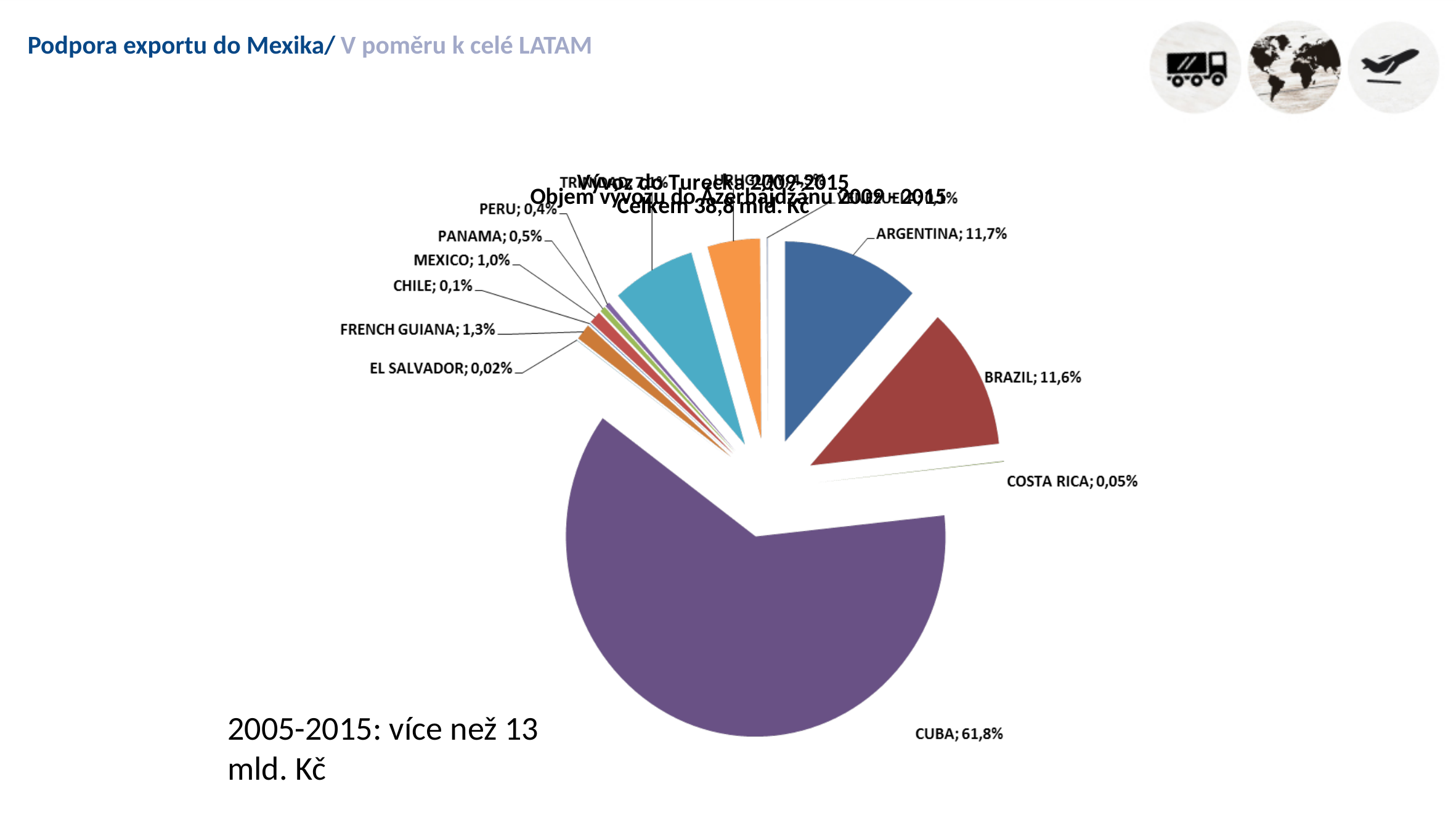
What is the difference in percentage points between CUBA and ARGENTINA? 50,1% What is the value shown for PANAMA? 0,5% What colour is the CUBA slice? purple What is the value shown for MEXICO? 1,0% What share of the pie does CUBA hold? 61,8% What is the value shown for EL SALVADOR? 0,02% What is the value shown for FRENCH GUIANA? 1,3% What is the value shown for BRAZIL? 11,6% What is the value shown for COSTA RICA? 0,05% What kind of chart is shown on the slide? pie chart Which country has the largest slice of the pie? CUBA What is the value shown for ARGENTINA? 11,7%